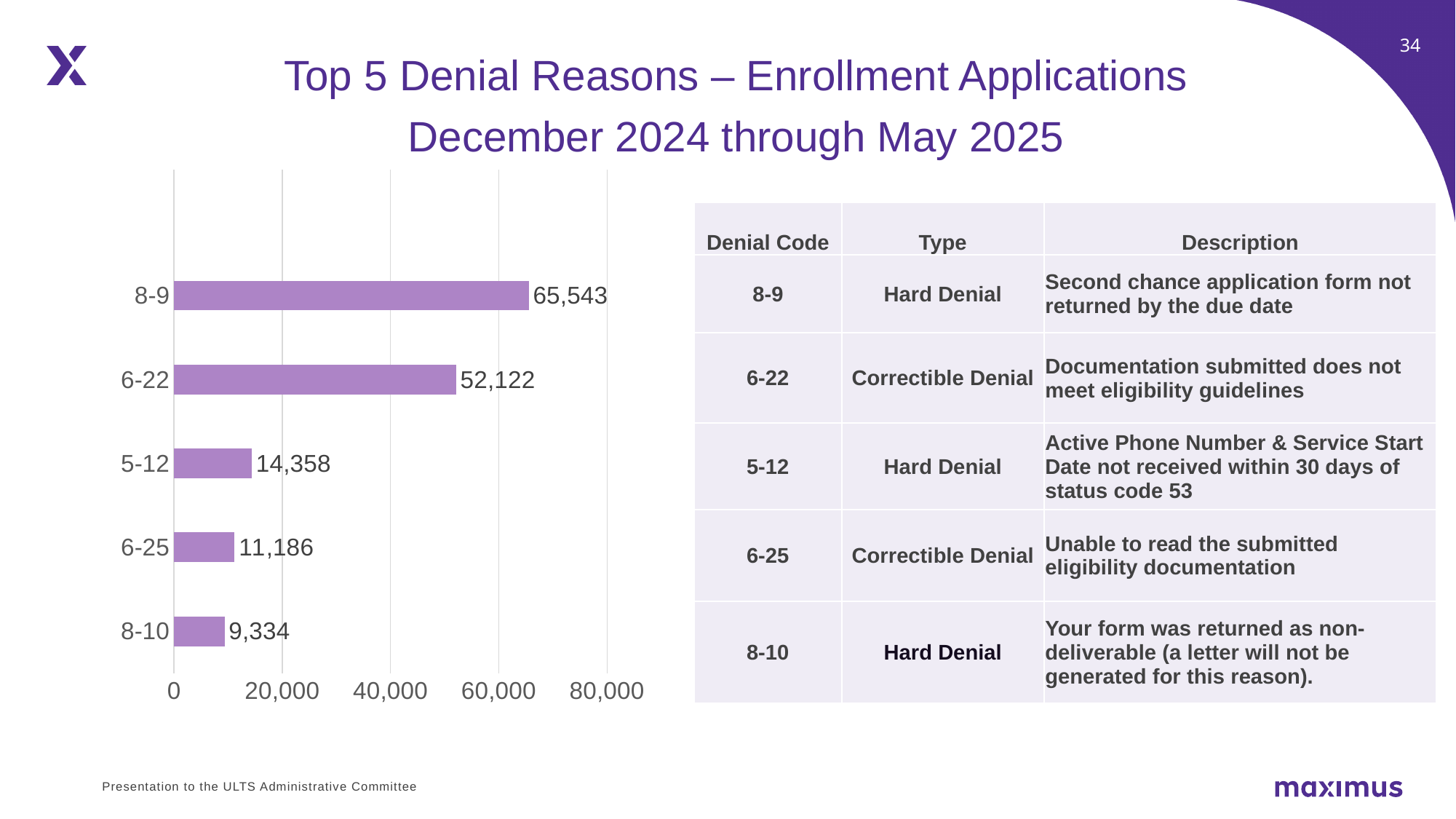
What is the value for denial code 5-12? 14,358 Is the value for 6-22 greater or less than 40,000? greater What is the difference between the values for 6-25 and 8-10? 1,852 What kind of chart is shown on the slide? bar chart What is the difference between the values for 8-9 and 6-22? 13,421 How many denial codes are shown in the chart? 5 What is the value for denial code 6-22? 52,122 Which denial code has the highest value? 8-9 What is the value for denial code 8-10? 9,334 Which denial code has the lowest value? 8-10 Which is larger, the value for 5-12 or the value for 6-25? 5-12 What is the value for denial code 8-9? 65,543